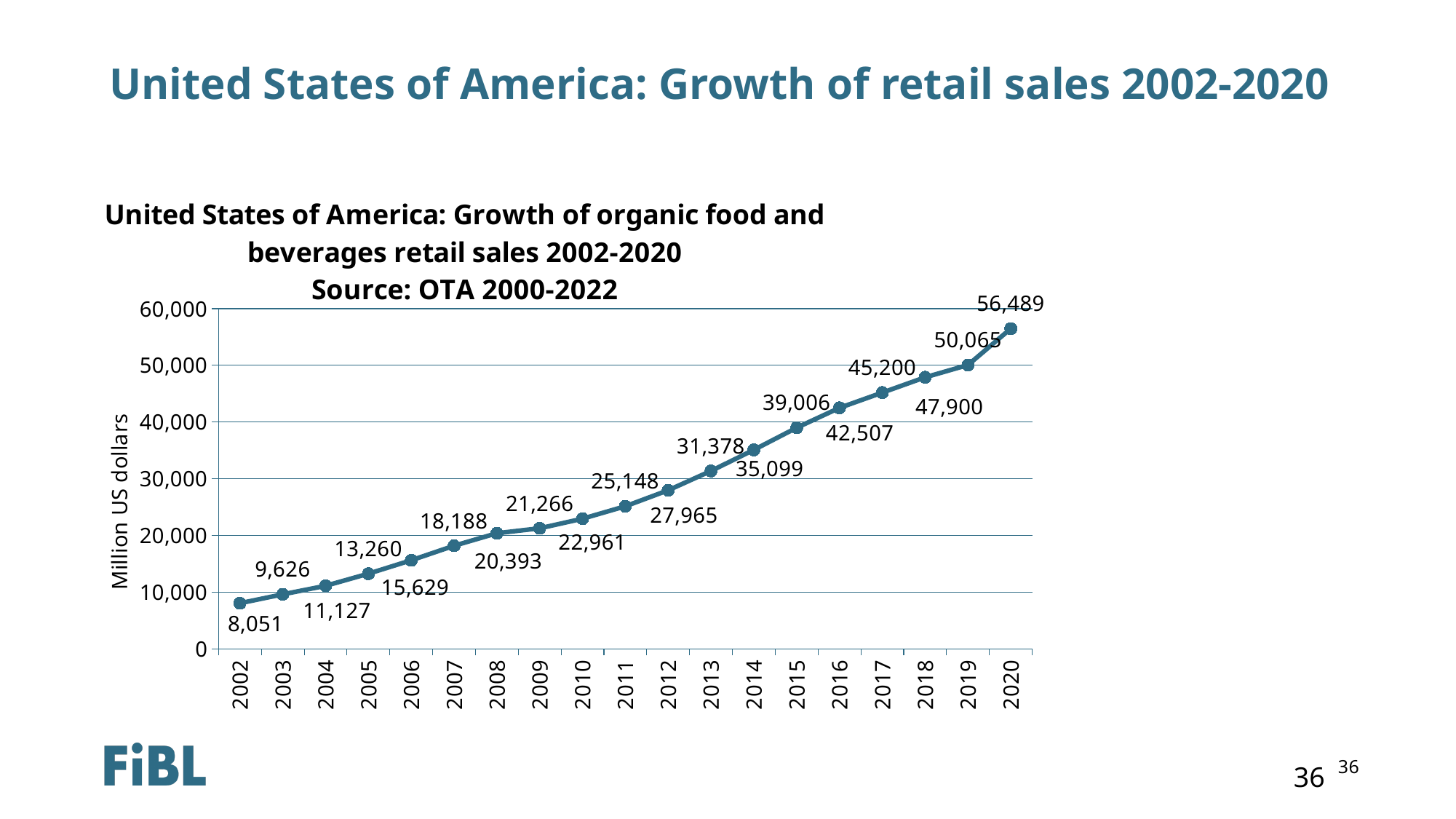
What is the value for 2010? 22,961 What is the difference between the values for 2020 and 2019? 6,424 Which year has the highest value? 2020 What kind of chart is shown on the slide? Line chart What is the value for 2016? 42,507 Which is larger, the value for 2008 or the value for 2009? 2009 What is the difference between the values for 2012 and 2011? 2,817 Do the values rise or fall from 2002 to 2020? Rise Which year has the lowest value? 2002 How many years are plotted on the chart? 19 What is the value for 2020? 56,489 What is the value for 2002? 8,051